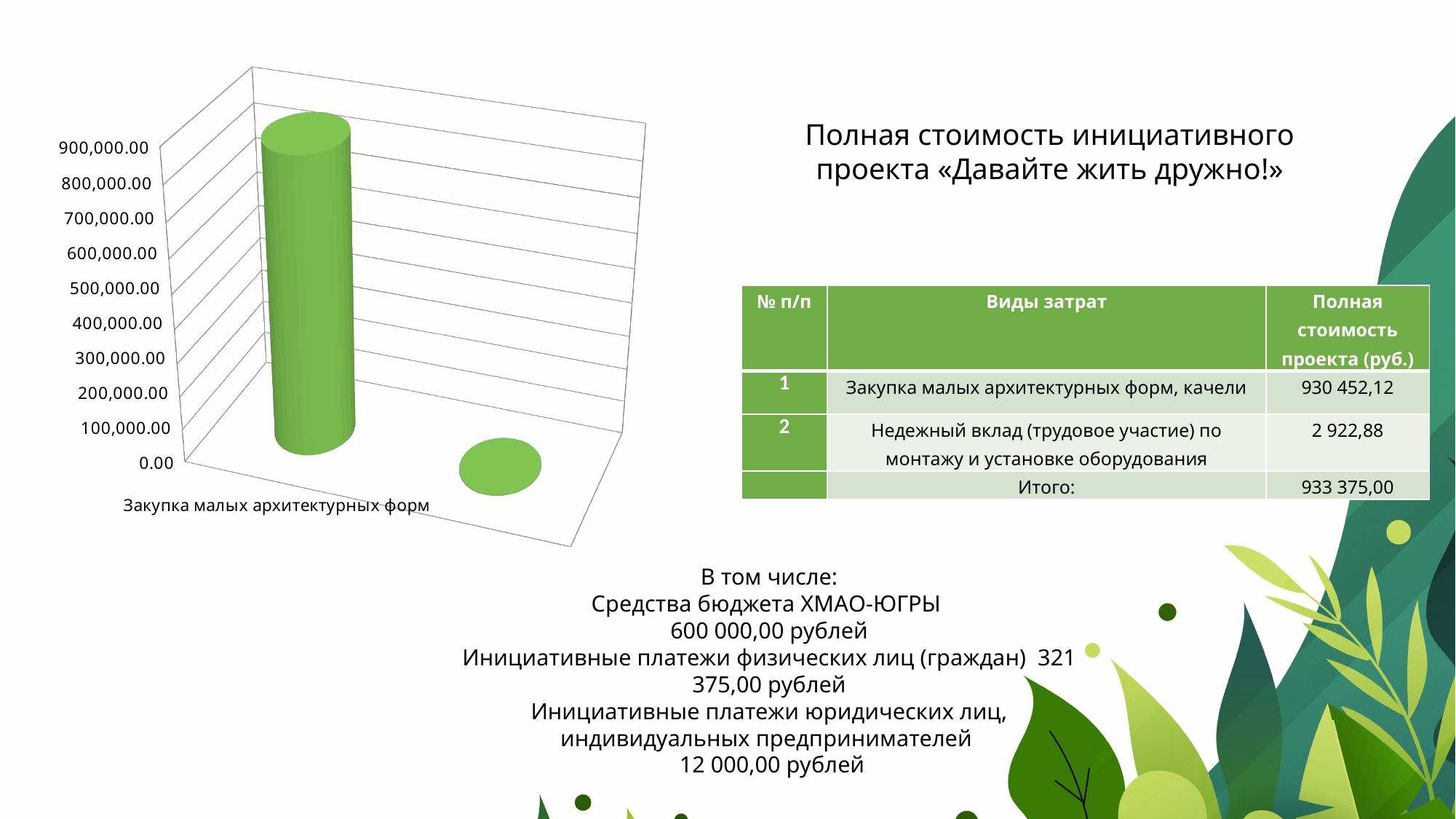
What category label is printed below the chart? Закупка малых архитектурных форм Which bar in the chart is taller, the left one or the right one? the left one Is the value of the small right bar in the chart greater or less than 500,000.00? less What is the highest value labelled on the vertical axis of the chart? 900,000.00 Is the value of the tall left bar in the chart greater or less than 500,000.00? greater How many bars are plotted in the chart? 2 What kind of chart is shown on the slide? bar chart Is the value of the small right bar in the chart greater or less than 100,000.00? less